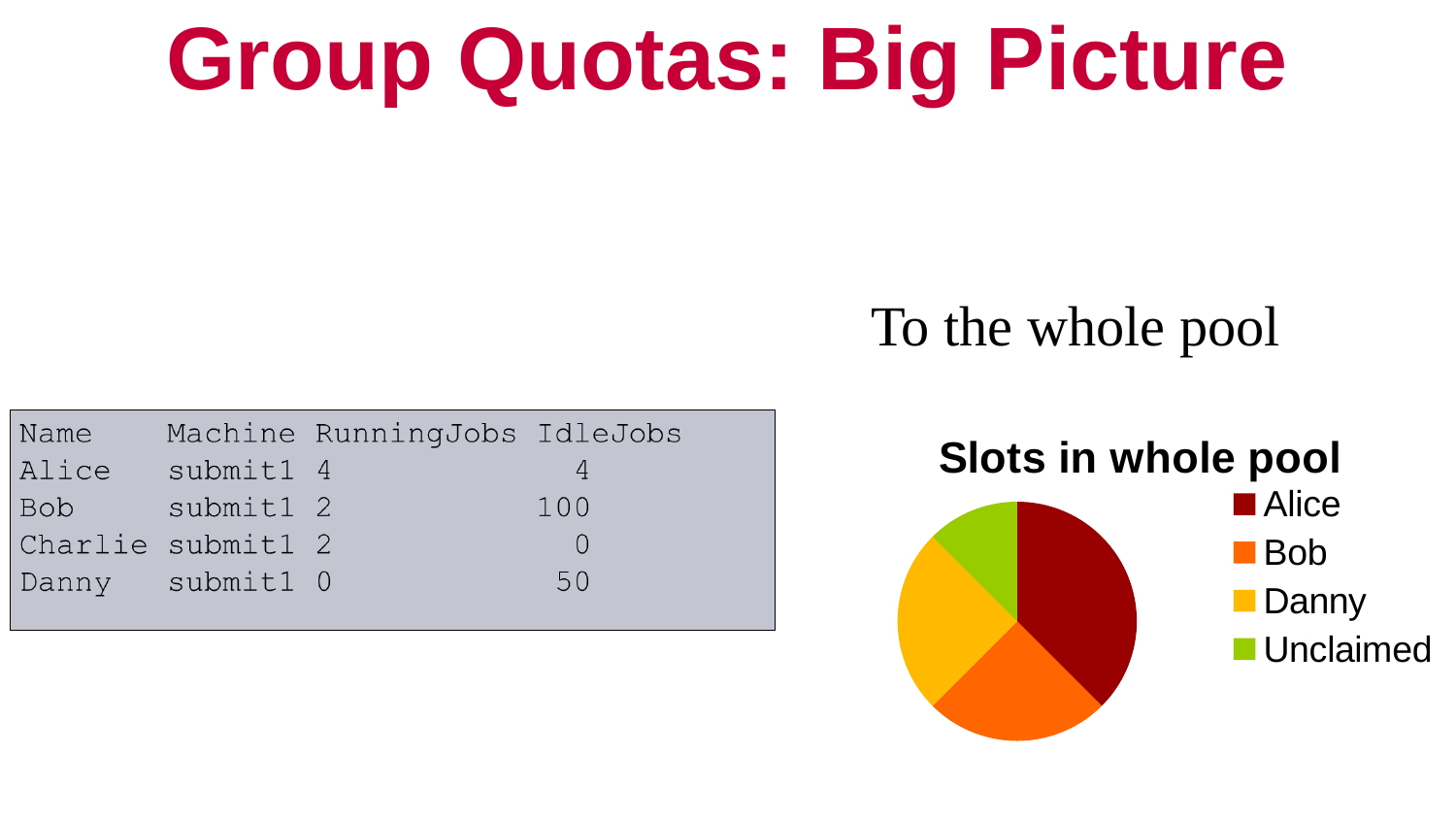
How many entries does the legend of the pie chart list? 4 In the pie chart, which slice is larger, Unclaimed or Alice? Alice Which legend entry in the pie chart is shown in green? Unclaimed What is the title of the pie chart? Slots in whole pool Which category has the smallest slice in the pie chart? Unclaimed In the pie chart, which slice is larger, Alice or Bob? Alice In the pie chart, which slice is larger, Danny or Unclaimed? Danny What kind of chart is shown on the slide? pie chart Which category has the largest slice in the pie chart? Alice How many slices does the pie chart have? 4